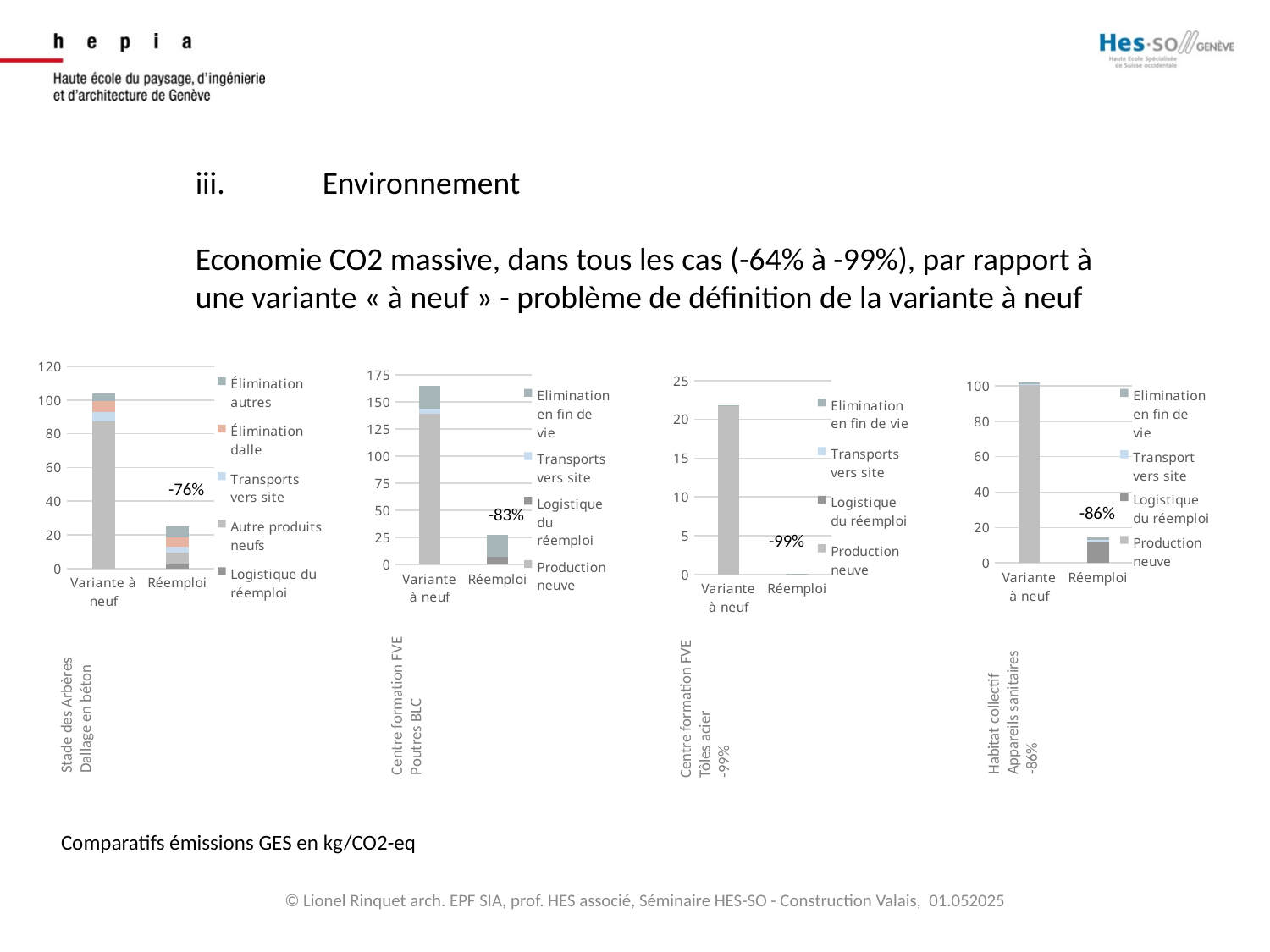
How many series does the legend of the second chart from the left (Centre formation FVE, Poutres BLC) list? 4 What percentage reduction is annotated next to the Réemploi bar in the second chart from the left (Centre formation FVE, Poutres BLC)? -83% In the second chart from the left (Centre formation FVE, Poutres BLC), is the total for Variante à neuf greater or less than 150? greater In the leftmost chart (Stade des Arbères, Dallage en béton), is the total for Réemploi greater or less than 40? less In the third chart from the left (Centre formation FVE, Tôles acier), is the total for Variante à neuf greater or less than 20? greater How many categories are shown on the x axis of the leftmost chart (Stade des Arbères, Dallage en béton)? 2 What percentage reduction is annotated next to the Réemploi bar in the leftmost chart (Stade des Arbères, Dallage en béton)? -76% In the leftmost chart (Stade des Arbères, Dallage en béton), which category has the higher total bar, Variante à neuf or Réemploi? Variante à neuf How many series does the legend of the leftmost chart (Stade des Arbères, Dallage en béton) list? 5 In the rightmost chart (Habitat collectif, Appareils sanitaires), which category has the lowest total bar? Réemploi What kind of chart is the leftmost chart (Stade des Arbères, Dallage en béton)? bar chart